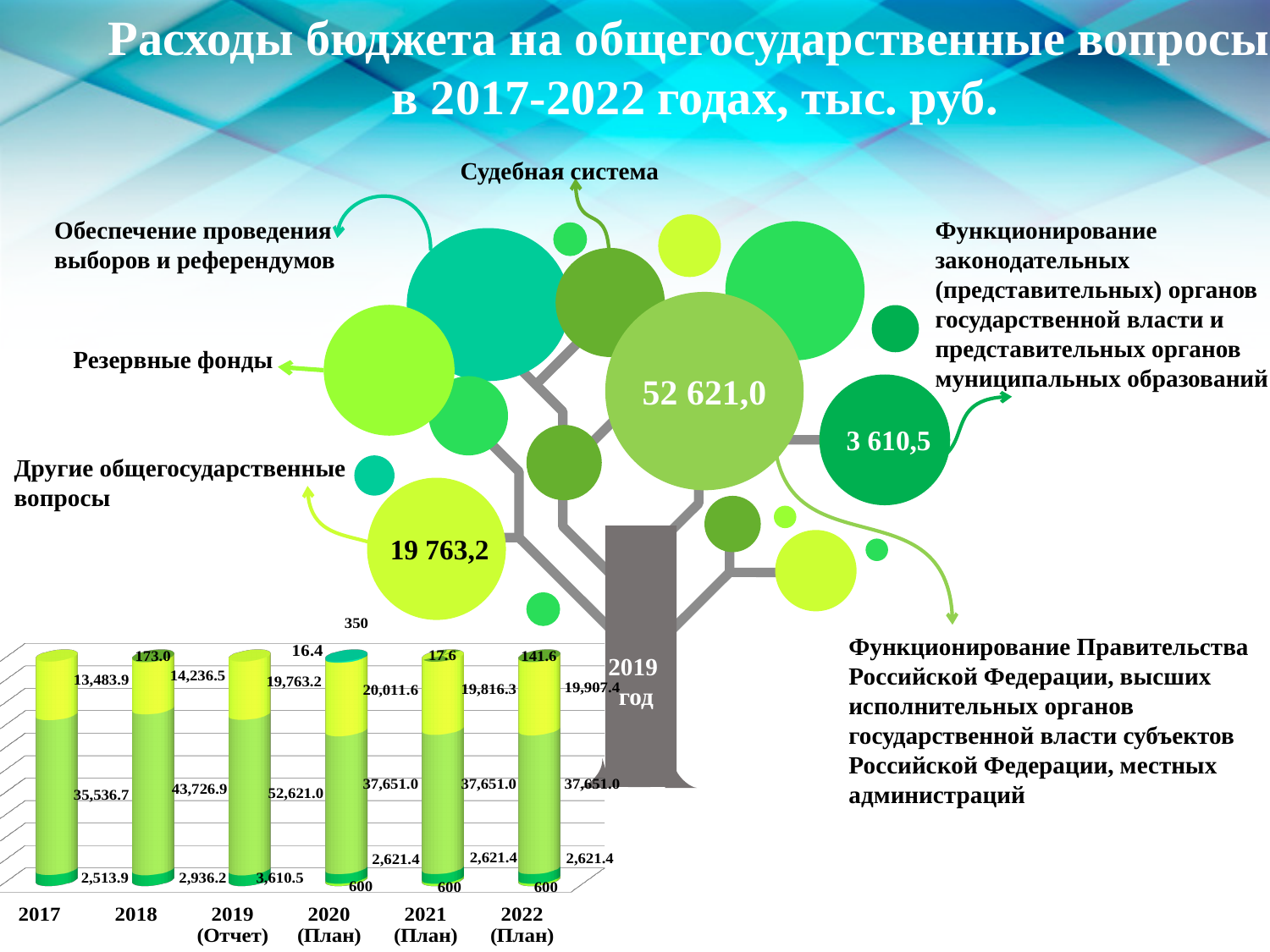
In the bar chart, does the middle segment value rise or fall from 2017 to 2019? rise What value is printed in the largest circle of the tree diagram? 52 621,0 In the bar chart, what is the value of the top (yellow-green) segment for 2020 (План)? 20,011.6 What type of chart is shown at the bottom left of the slide? bar chart How many year categories are shown on the x axis of the bar chart? 6 In the bar chart, what is the value of the middle segment for 2018? 43,726.9 In the bar chart, what is the value of the bottom segment for 2017? 2,513.9 In the bar chart, what is the value of the middle (largest) segment for 2019 (Отчет)? 52,621.0 In the bar chart, what is the difference between the middle segment values for 2019 (Отчет) and 2018? 8,894.1 In the bar chart, which year has the highest value for the middle segment? 2019 (Отчет) In the bar chart, which is larger: the top segment for 2017 or for 2018? 2018